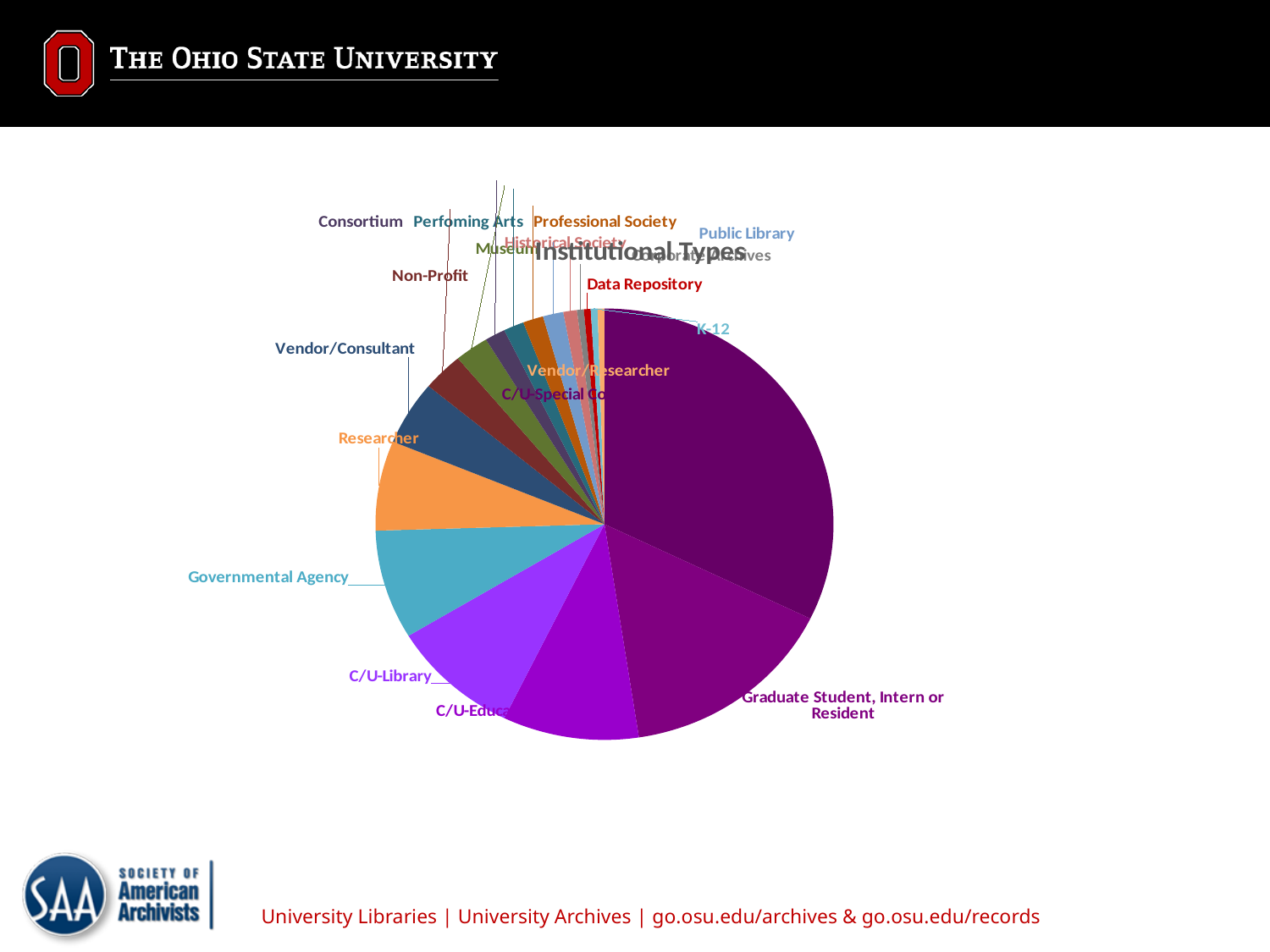
Which slice is larger, Governmental Agency or Public Library? Governmental Agency Which slice is larger, Governmental Agency or Non-Profit? Governmental Agency What colour is the Researcher slice? orange Which slice is larger, C/U-Library or Professional Society? C/U-Library What kind of chart is shown on the slide? pie chart What is the title of the chart? Institutional Types